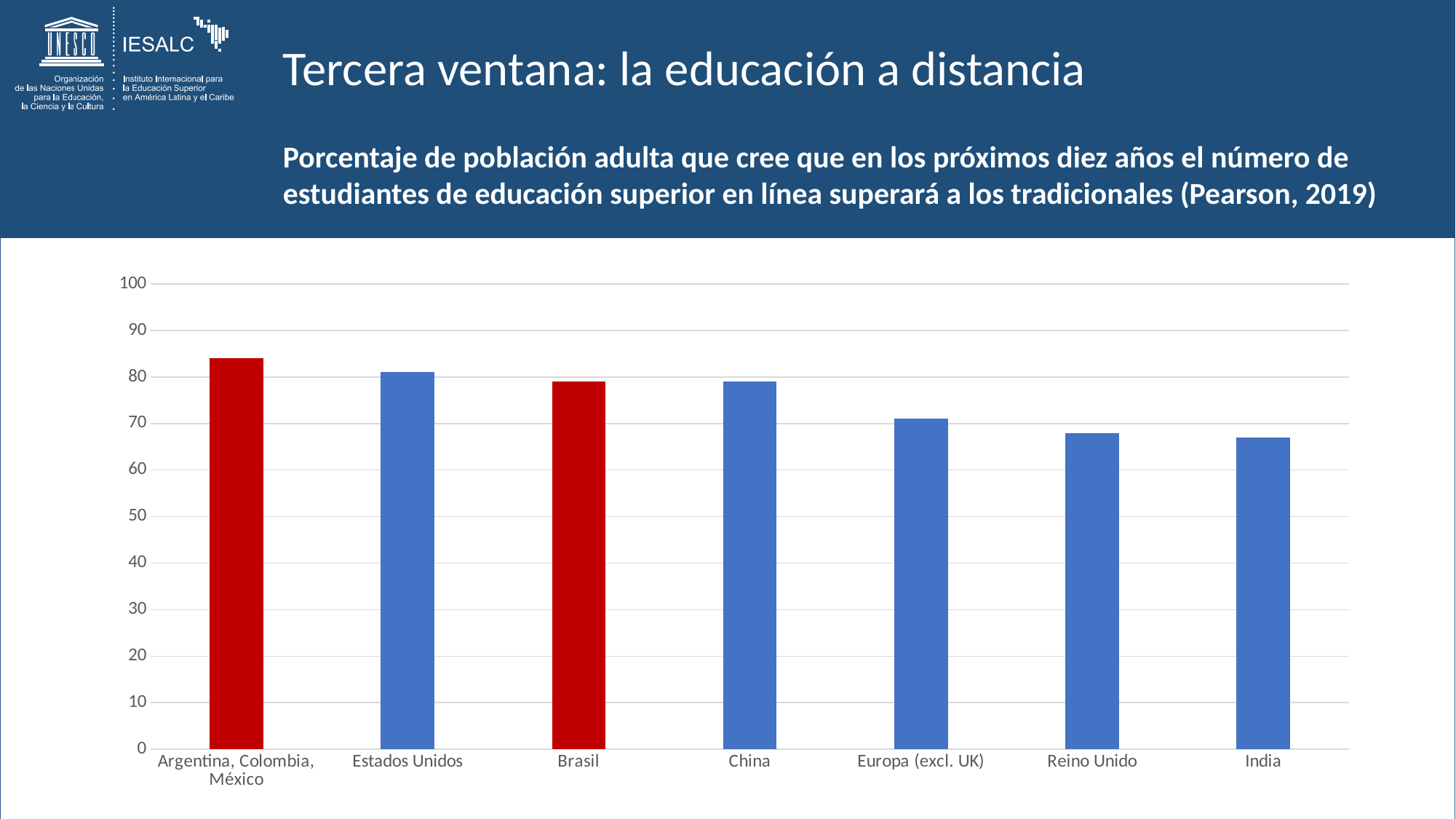
Which has a larger value, Argentina, Colombia, México or China? Argentina, Colombia, México How many categories are shown on the x axis of the chart? 7 Which category has the highest value in the chart? Argentina, Colombia, México Which has a larger value, Europa (excl. UK) or India? Europa (excl. UK) Is the value for Argentina, Colombia, México greater or less than 80? greater Which two categories are shown with red bars instead of blue? Argentina, Colombia, México and Brasil Is the value for India greater or less than 70? less What kind of chart is shown on the slide? bar chart Do the values generally rise or fall from left to right along the x axis? fall